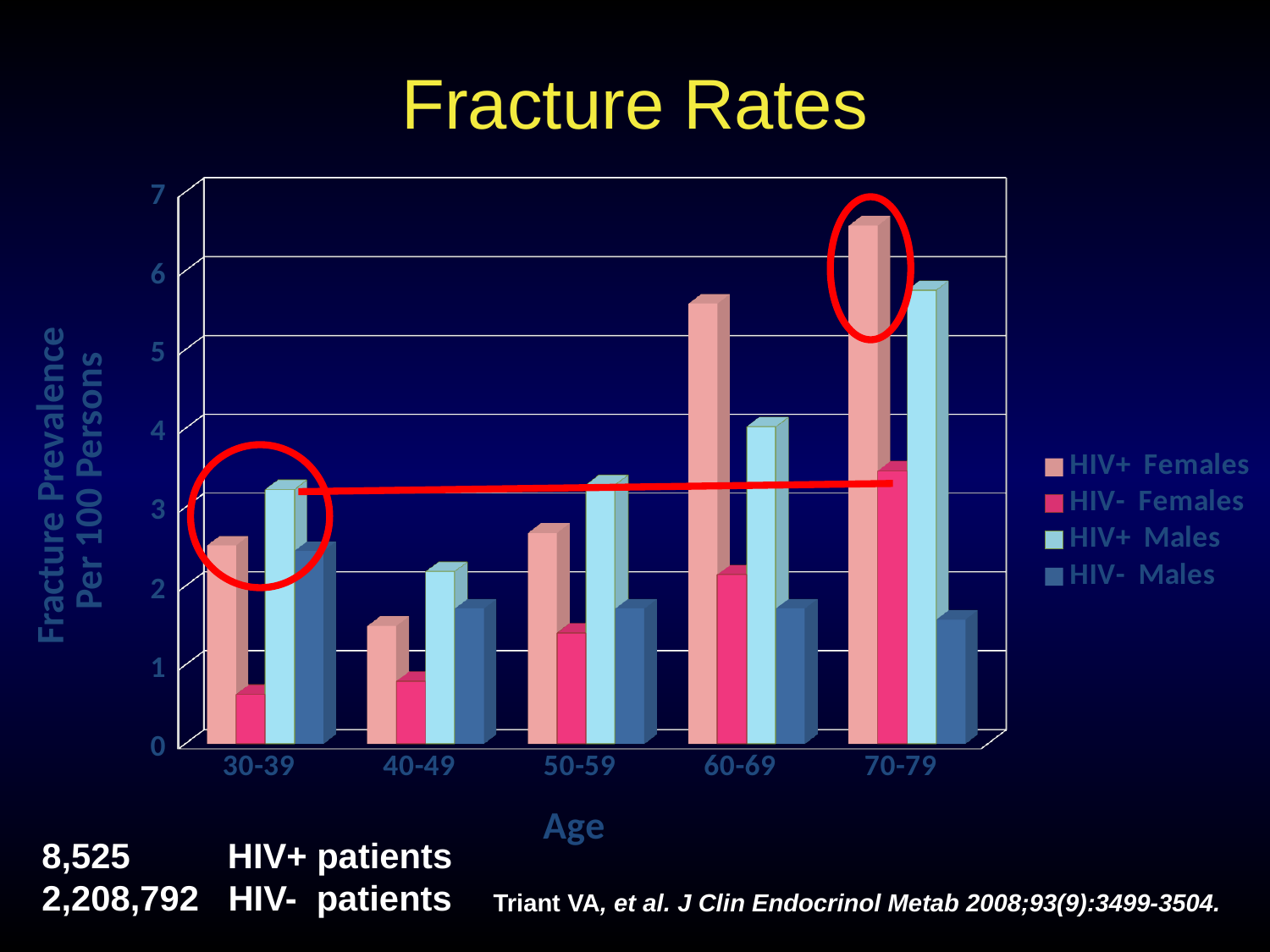
Is the value for HIV+ Males in the 70-79 age group greater or less than 5? greater Is the value for HIV+ Females in the 70-79 age group greater or less than 6? greater Is the value for HIV- Females in the 30-39 age group greater or less than 1? less Which age group has the lowest fracture prevalence for HIV- Females? 30-39 In the 30-39 age group, which is larger: HIV+ Males or HIV+ Females? HIV+ Males What kind of chart is shown on the slide? bar chart Which age group has the highest fracture prevalence for HIV+ Females? 70-79 What is the title of the y axis? Fracture Prevalence Per 100 Persons In the 60-69 age group, which is larger: HIV+ Females or HIV+ Males? HIV+ Females How many series does the legend list? 4 How many age groups are shown on the x axis? 5